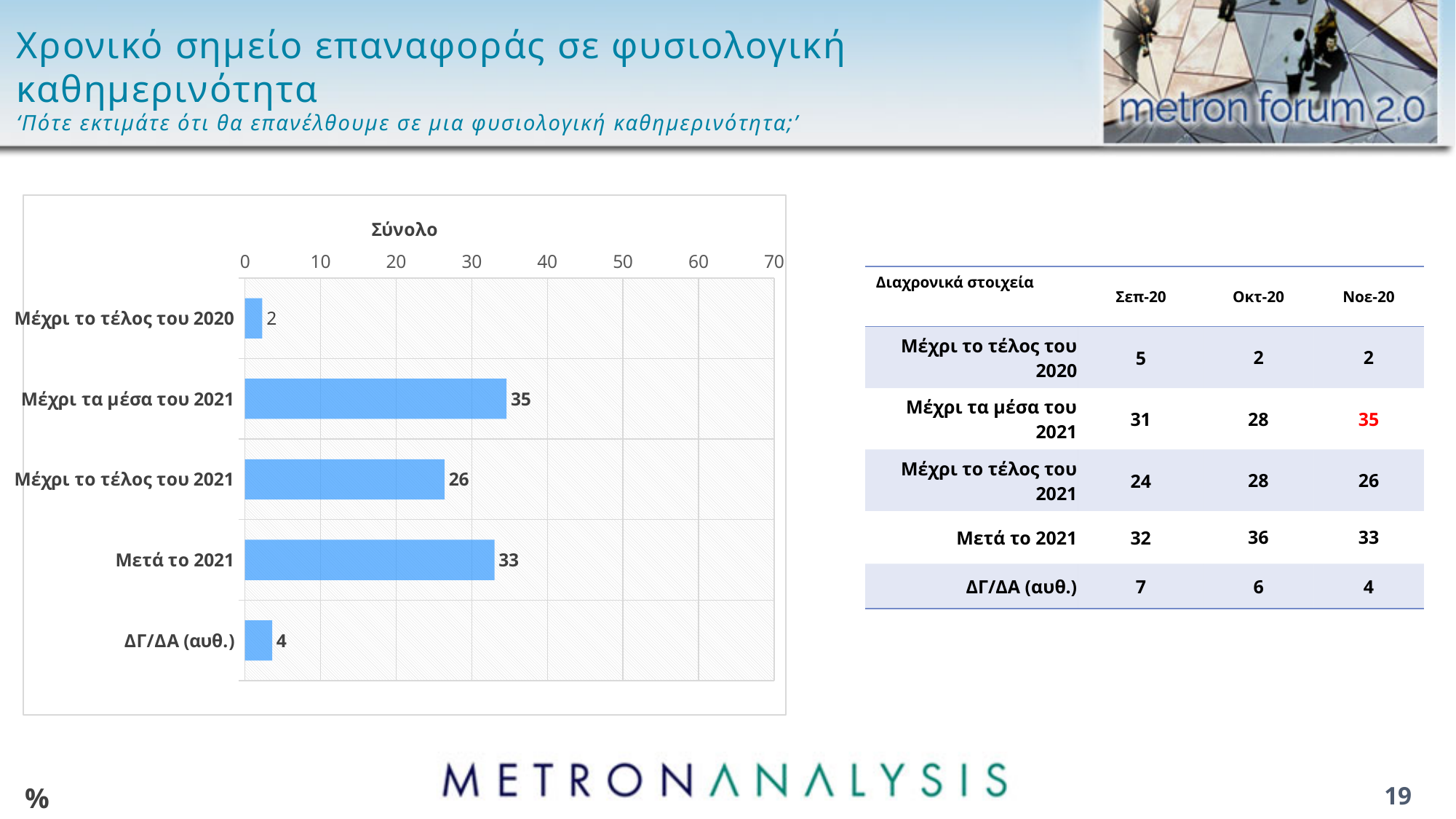
How many categories are shown in the chart? 5 What is the difference between the values for 'Μέχρι τα μέσα του 2021' and 'Μέχρι το τέλος του 2021'? 9 What is the value for 'Μέχρι τα μέσα του 2021' in the chart? 35 What kind of chart is shown on the slide? bar chart What is the value for 'ΔΓ/ΔΑ (αυθ.)' in the chart? 4 Which is larger: the value for 'Μετά το 2021' or the value for 'Μέχρι το τέλος του 2021'? Μετά το 2021 Which category has the highest value in the chart? Μέχρι τα μέσα του 2021 What is the value for 'Μέχρι το τέλος του 2020' in the chart? 2 What is the value for 'Μετά το 2021' in the chart? 33 Is the value for 'Μέχρι τα μέσα του 2021' greater or less than 30? greater Which category has the lowest value in the chart? Μέχρι το τέλος του 2020 What is the title shown above the chart? Σύνολο